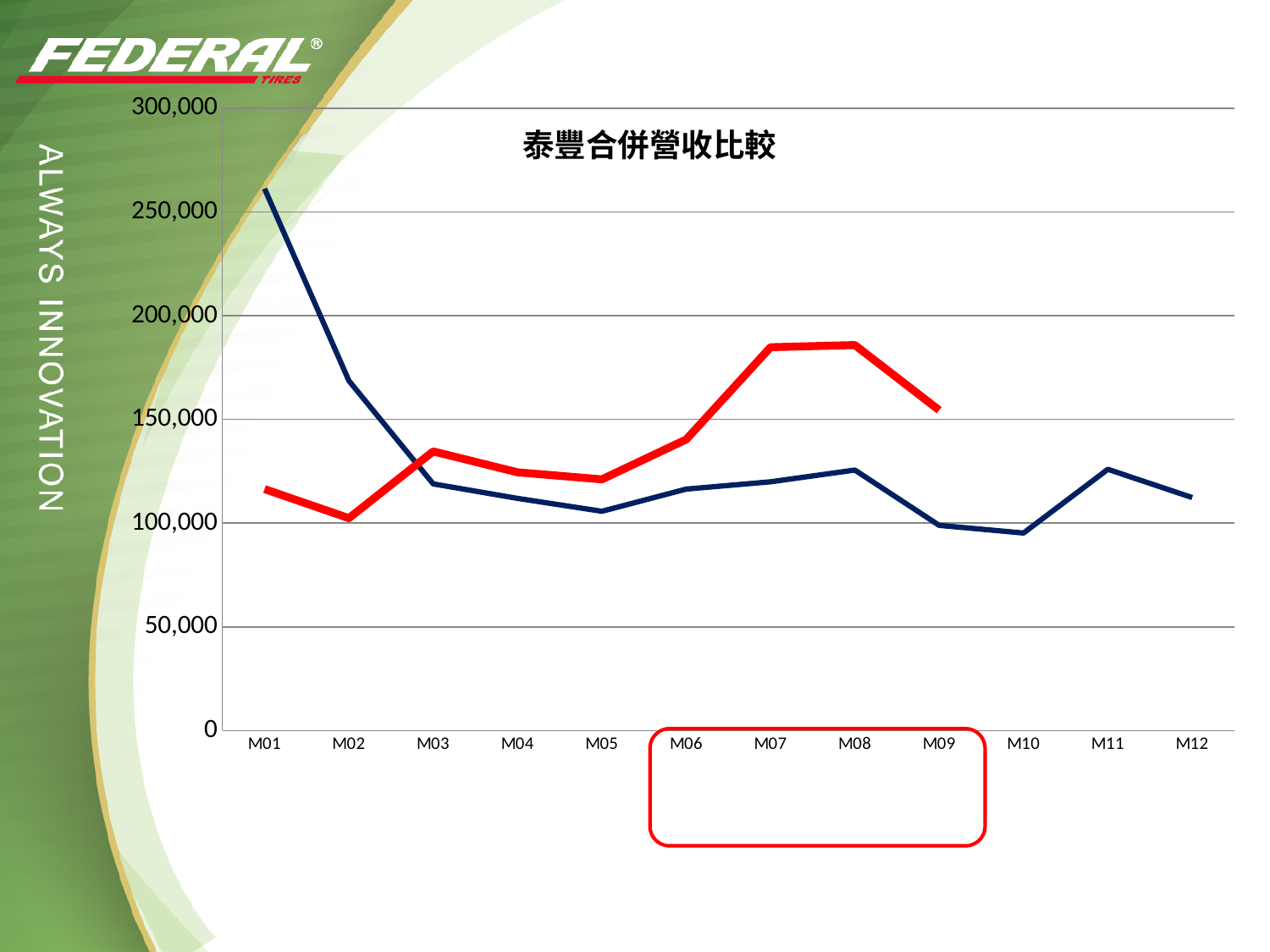
In which month does the dark blue line reach its highest value? M01 Is the value of the dark blue line at M10 greater or less than 100,000? less Is the value of the dark blue line at M01 greater or less than 250,000? greater At M07, which line has the higher value, the red line or the dark blue line? red line Does the dark blue line rise or fall from M01 to M05? fall How many months are labelled along the x axis of the chart? 12 What kind of chart is shown on the slide? line chart Is the value of the red line at M07 greater or less than 150,000? greater In which month does the red line reach its lowest value? M02 What is the title of the chart? 泰豐合併營收比較 Up to which month does the red line extend on the x axis? M09 How many lines are plotted in the chart? 2